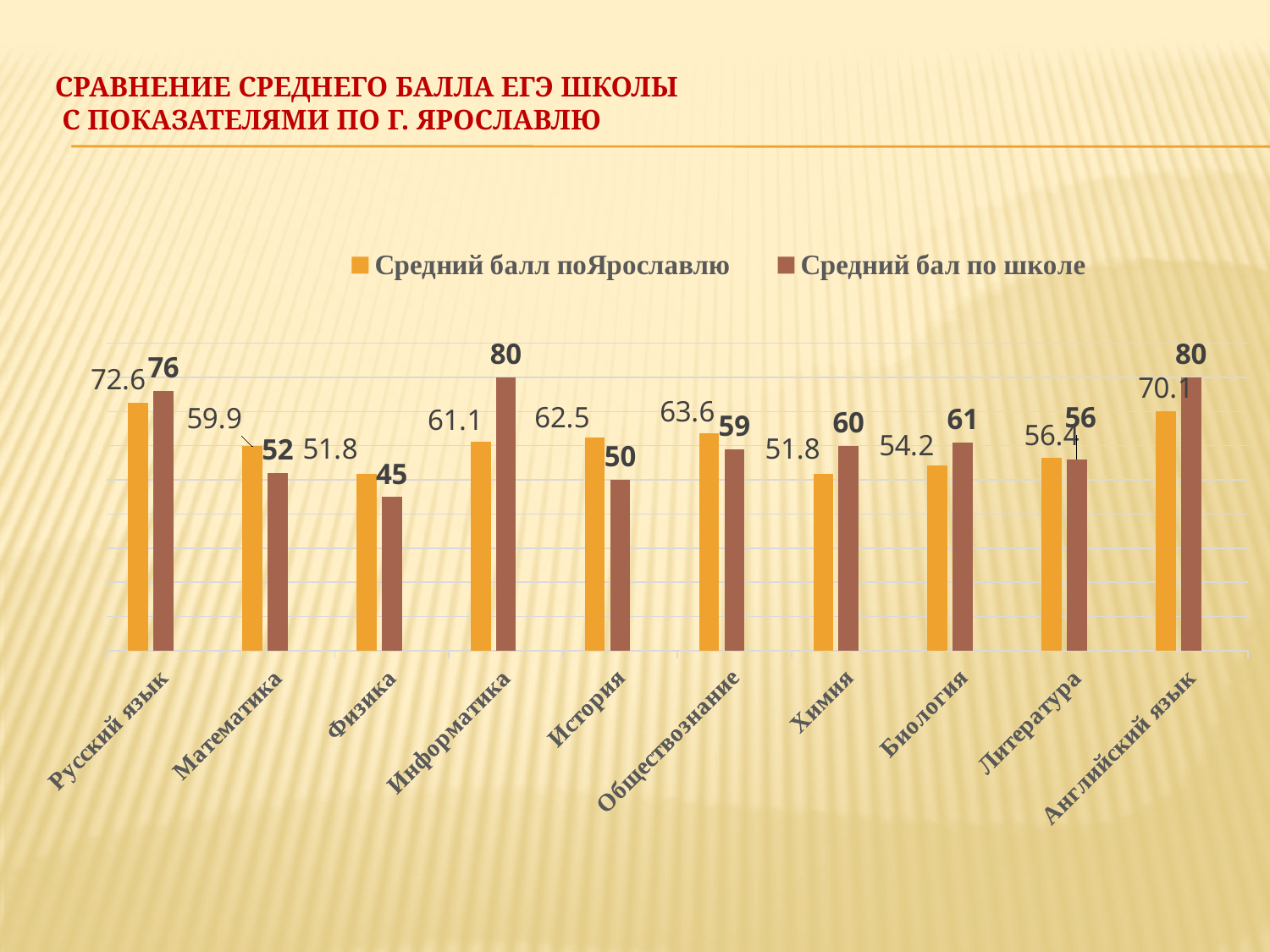
What kind of chart is shown on the slide? Bar chart Which category has the lowest value in the series Средний бал по школе? Физика What is the difference between the Средний бал по школе and Средний балл поЯрославлю values for Информатика? 18.9 How many categories are shown on the x axis? 10 What is the value for Физика in the series Средний бал по школе? 45 What is the difference between the Средний балл поЯрославлю and Средний бал по школе values for Математика? 7.9 What is the value for Английский язык in the series Средний балл поЯрославлю? 70.1 What is the value for Русский язык in the series Средний бал по школе? 76 How many series does the legend list? 2 What is the value for Информатика in the series Средний балл поЯрославлю? 61.1 For История, which series has the larger value: Средний балл поЯрославлю or Средний бал по школе? Средний балл поЯрославлю Which category has the highest value in the series Средний балл поЯрославлю? Русский язык